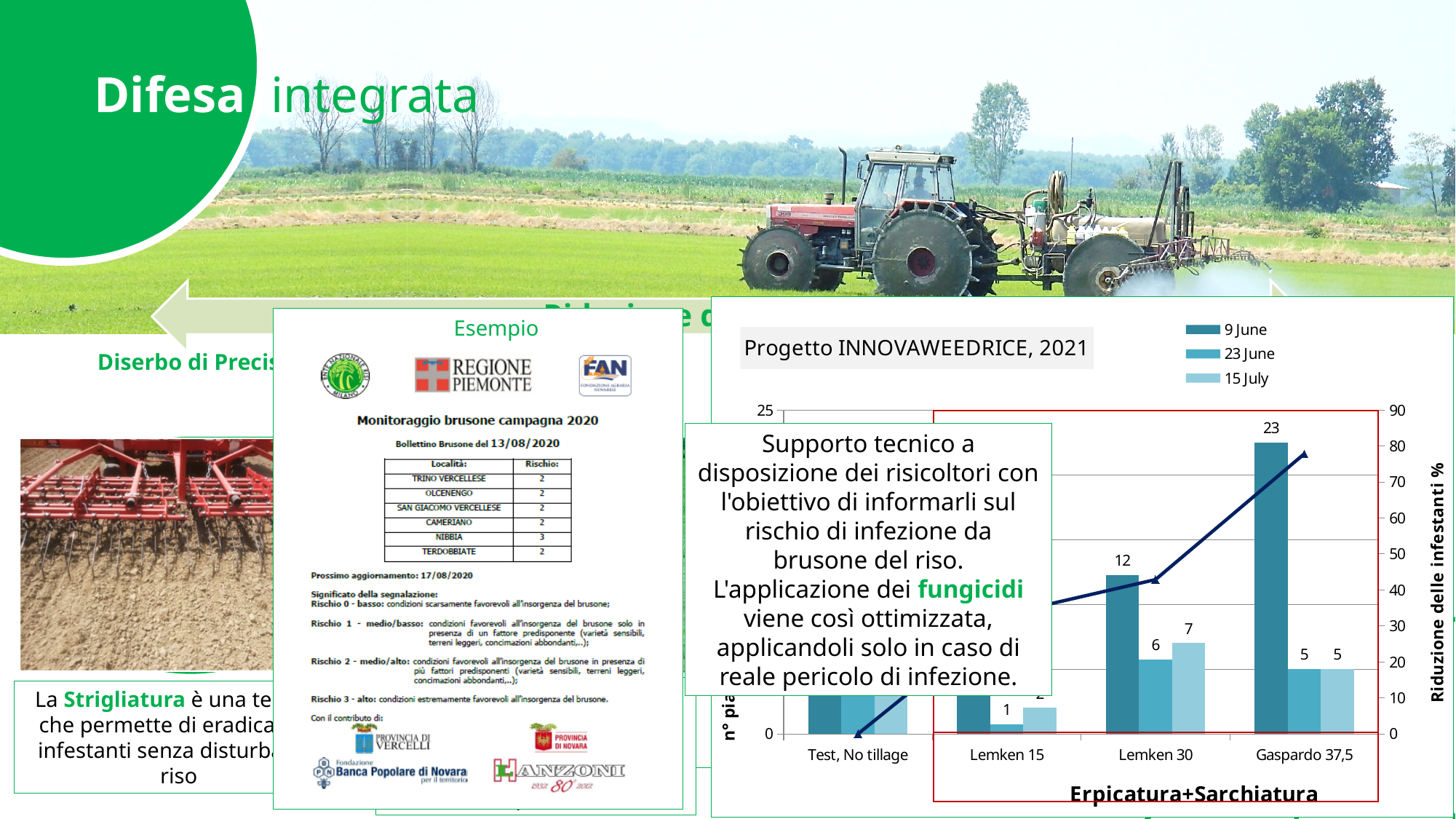
In the Progetto INNOVAWEEDRICE, 2021 chart, what is the difference between the 9 June values for Gaspardo 37,5 and Lemken 30? 11 In the Progetto INNOVAWEEDRICE, 2021 chart, what is the 9 June value for Gaspardo 37,5? 23 In the Progetto INNOVAWEEDRICE, 2021 chart, what is the 15 July value for Lemken 30? 7 In the Progetto INNOVAWEEDRICE, 2021 chart, what is the title of the right-hand vertical axis? Riduzione delle infestanti % In the Progetto INNOVAWEEDRICE, 2021 chart, how many categories are shown on the x axis? 4 In the Progetto INNOVAWEEDRICE, 2021 chart, what is the 23 June value for Lemken 15? 1 In the Progetto INNOVAWEEDRICE, 2021 chart, what is the 23 June value for Gaspardo 37,5? 5 In the Progetto INNOVAWEEDRICE, 2021 chart, does the Riduzione delle infestanti % line rise or fall from Test, No tillage to Gaspardo 37,5? rise In the Progetto INNOVAWEEDRICE, 2021 chart, which has the higher 9 June value, Lemken 30 or Gaspardo 37,5? Gaspardo 37,5 In the Progetto INNOVAWEEDRICE, 2021 chart, what is the 9 June value for Lemken 30? 12 In the Progetto INNOVAWEEDRICE, 2021 chart, how many series does the legend list? 3 In the Progetto INNOVAWEEDRICE, 2021 chart, is the line value (Riduzione delle infestanti %) for Gaspardo 37,5 greater or less than 70? greater